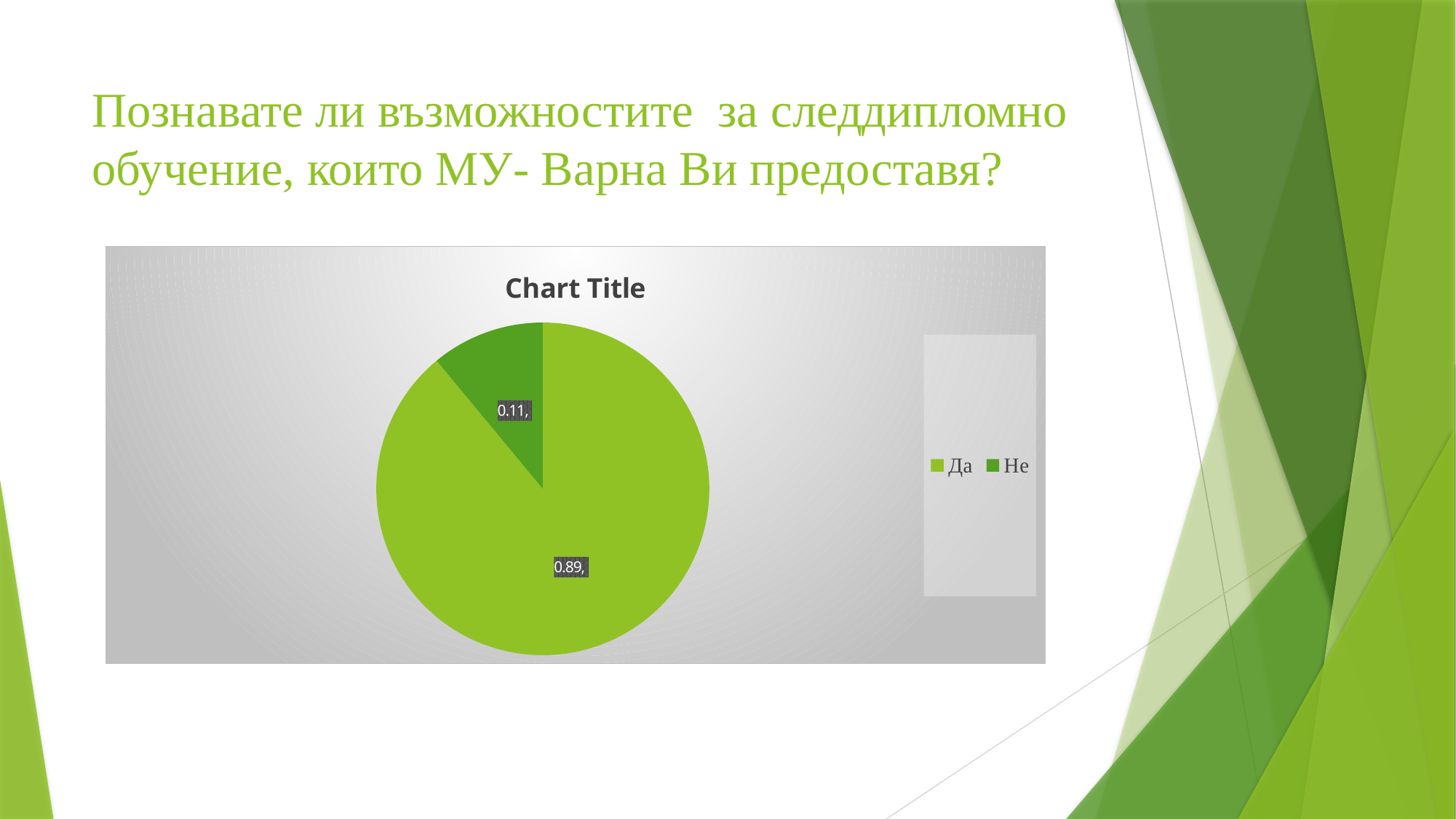
Which legend entries are listed for the pie chart? Да and Не What is the title shown above the pie chart? Chart Title What kind of chart is shown on the slide? pie chart What is the difference between the Да value and the Не value? 0.78 How many slices does the pie chart have? 2 Which slice is the smallest? Не Which slice is the largest? Да What is the value shown for the Да slice? 0.89 What is the value shown for the Не slice? 0.11 Which is larger, the Да slice or the Не slice? Да How many entries does the legend list? 2